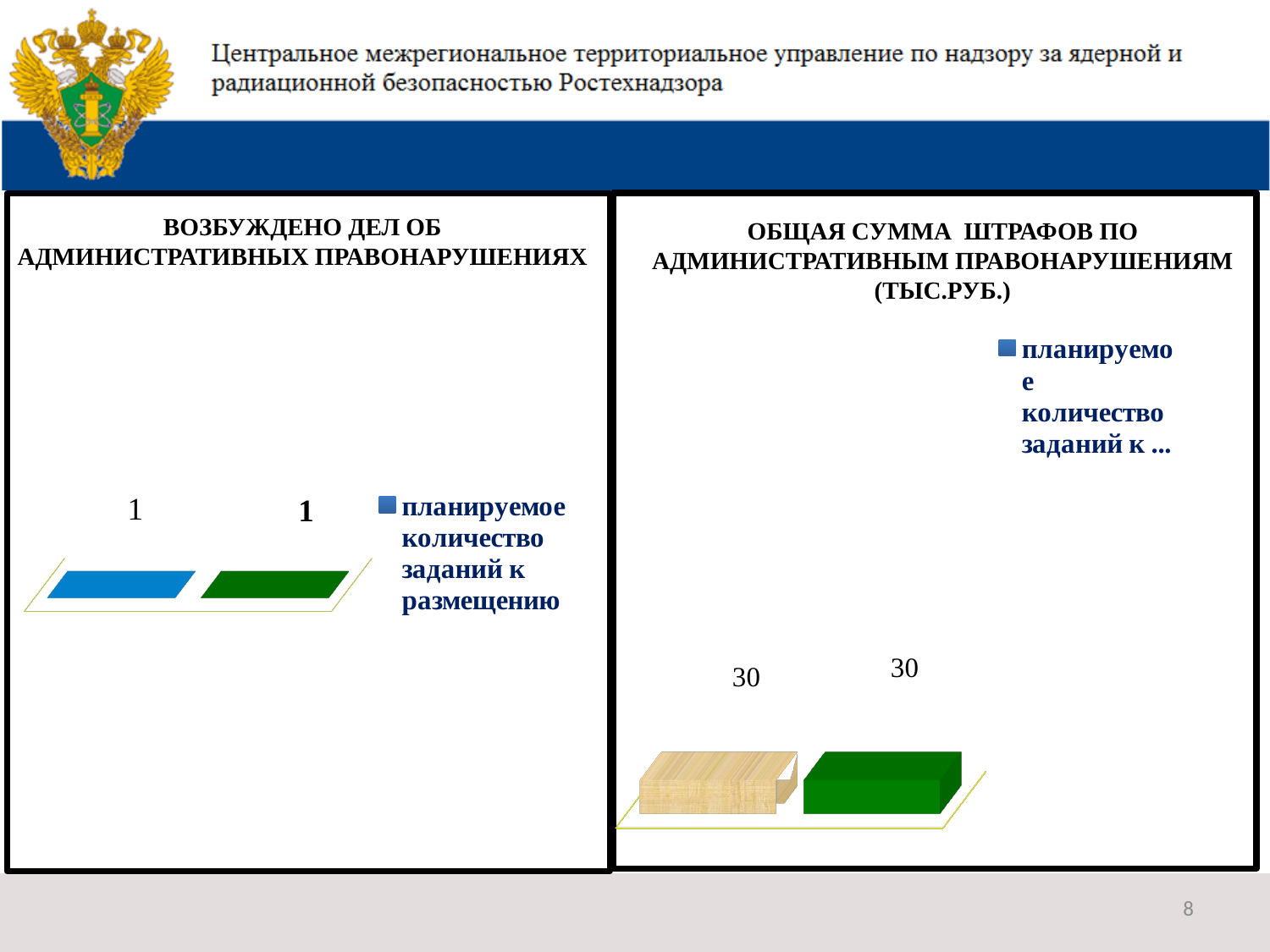
On the left chart 'ВОЗБУЖДЕНО ДЕЛ ОБ АДМИНИСТРАТИВНЫХ ПРАВОНАРУШЕНИЯХ', how many entries does the legend list? 1 On the left chart 'ВОЗБУЖДЕНО ДЕЛ ОБ АДМИНИСТРАТИВНЫХ ПРАВОНАРУШЕНИЯХ', what value is shown on the blue bar? 1 On the right chart 'ОБЩАЯ СУММА ШТРАФОВ ПО АДМИНИСТРАТИВНЫМ ПРАВОНАРУШЕНИЯМ (ТЫС.РУБ.)', what value is shown on the left (beige) bar? 30 On the left chart 'ВОЗБУЖДЕНО ДЕЛ ОБ АДМИНИСТРАТИВНЫХ ПРАВОНАРУШЕНИЯХ', what is the difference between the values of the two bars? 0 On the left chart 'ВОЗБУЖДЕНО ДЕЛ ОБ АДМИНИСТРАТИВНЫХ ПРАВОНАРУШЕНИЯХ', how many bars are plotted? 2 What unit is given in the title of the right chart 'ОБЩАЯ СУММА ШТРАФОВ ПО АДМИНИСТРАТИВНЫМ ПРАВОНАРУШЕНИЯМ'? ТЫС.РУБ. On the right chart 'ОБЩАЯ СУММА ШТРАФОВ ПО АДМИНИСТРАТИВНЫМ ПРАВОНАРУШЕНИЯМ (ТЫС.РУБ.)', how many bars are plotted? 2 What is the legend entry on the left chart 'ВОЗБУЖДЕНО ДЕЛ ОБ АДМИНИСТРАТИВНЫХ ПРАВОНАРУШЕНИЯХ'? планируемое количество заданий к размещению On the right chart 'ОБЩАЯ СУММА ШТРАФОВ ПО АДМИНИСТРАТИВНЫМ ПРАВОНАРУШЕНИЯМ (ТЫС.РУБ.)', what is the difference between the values of the two bars? 0 What kind of chart is the left chart 'ВОЗБУЖДЕНО ДЕЛ ОБ АДМИНИСТРАТИВНЫХ ПРАВОНАРУШЕНИЯХ'? bar chart On the left chart 'ВОЗБУЖДЕНО ДЕЛ ОБ АДМИНИСТРАТИВНЫХ ПРАВОНАРУШЕНИЯХ', what value is shown on the green bar? 1 On the right chart 'ОБЩАЯ СУММА ШТРАФОВ ПО АДМИНИСТРАТИВНЫМ ПРАВОНАРУШЕНИЯМ (ТЫС.РУБ.)', what value is shown on the green bar? 30